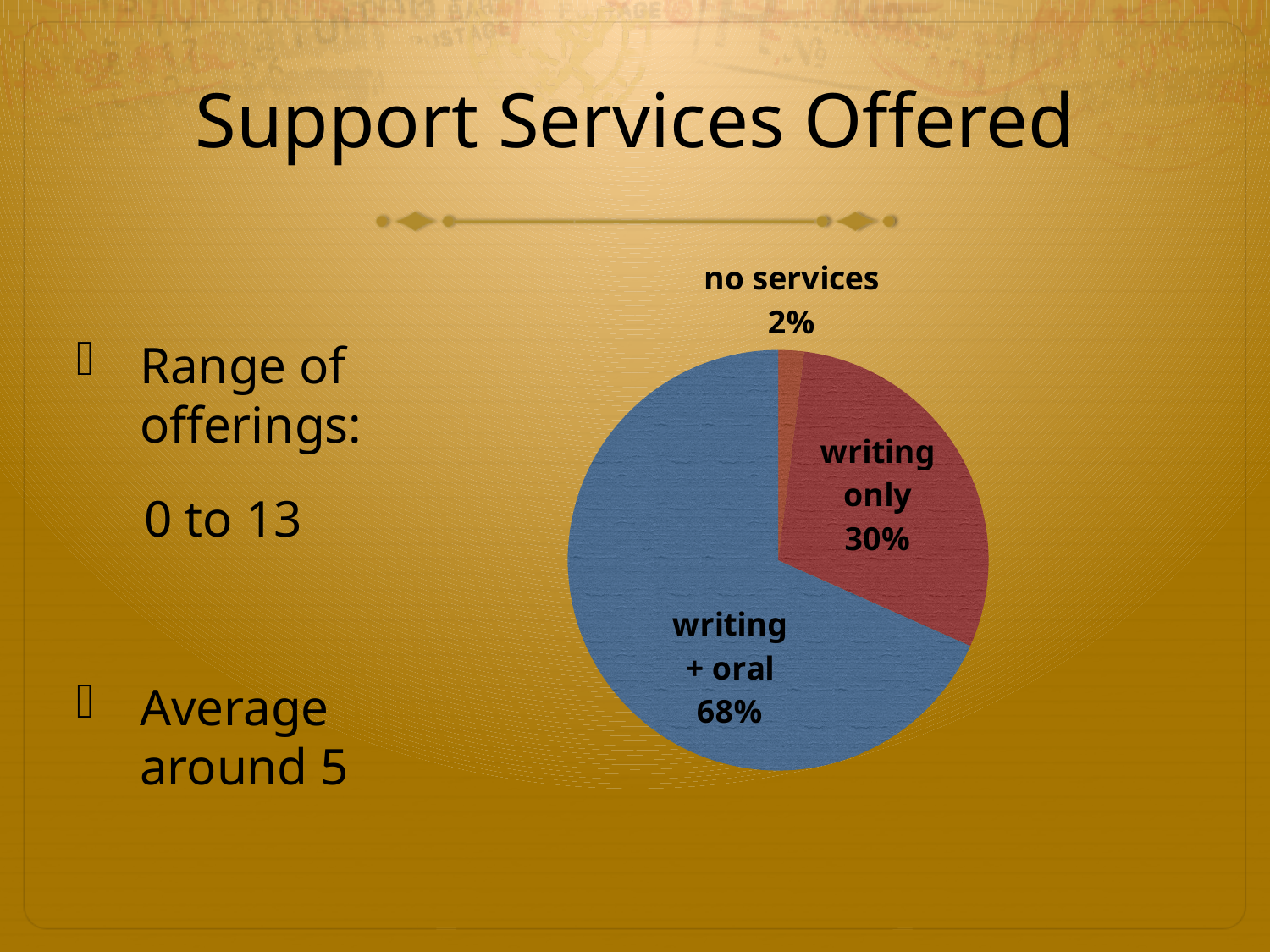
Which is larger, the 'writing only' slice or the 'no services' slice? writing only What colour is the 'writing only' slice? red Which category has the smallest slice of the pie? no services What is the difference in percentage points between 'writing + oral' and 'writing only'? 38 What share of the pie does the 'no services' slice represent? 2% Which category has the largest slice of the pie? writing + oral Is the share for 'writing + oral' greater or less than 50%? greater What share of the pie does the 'writing + oral' slice represent? 68% What share of the pie does the 'writing only' slice represent? 30% How many slices does the pie chart have? 3 What is the difference in percentage points between 'writing only' and 'no services'? 28 What kind of chart is shown on the slide? pie chart